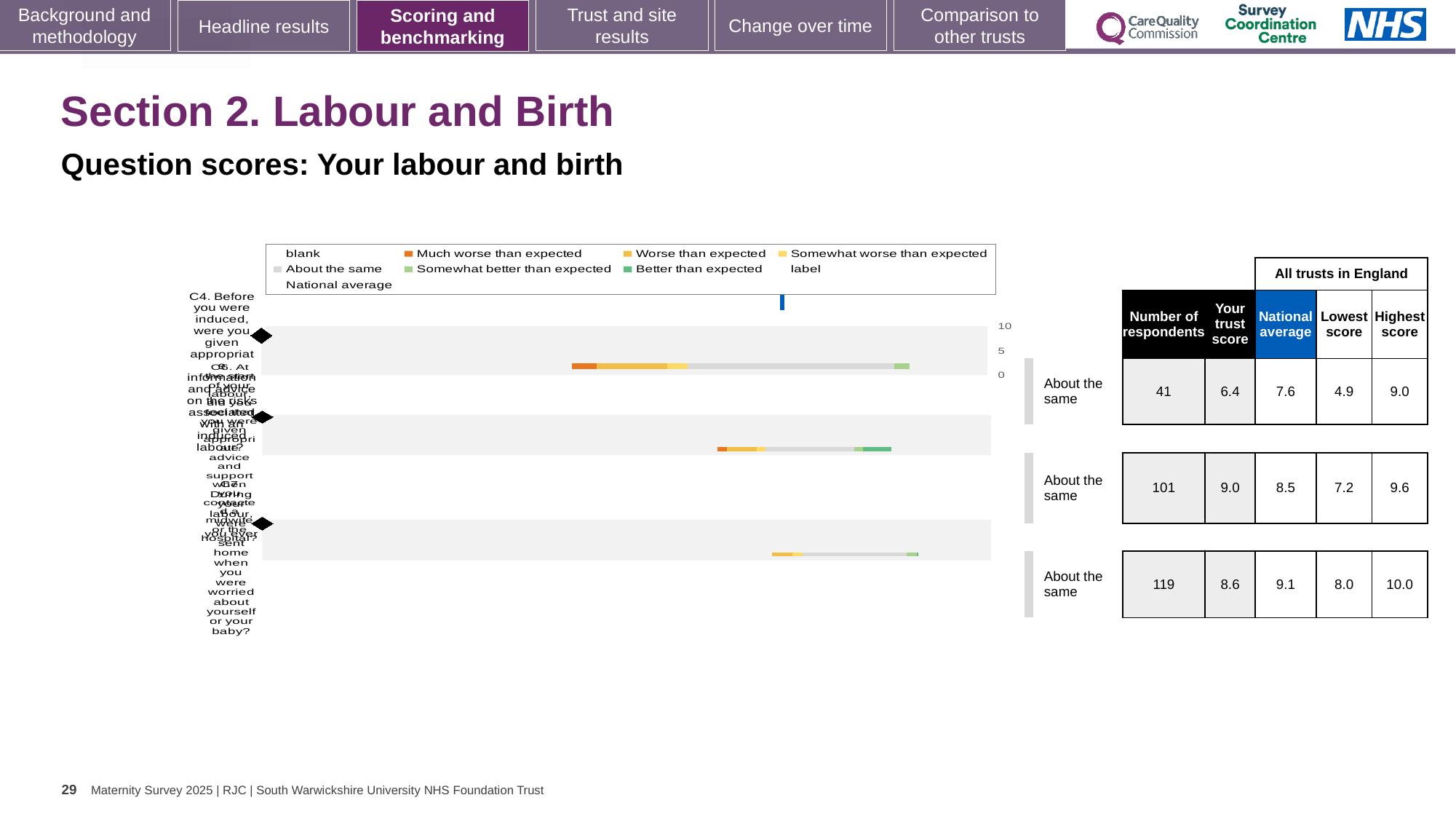
What benchmark label is shown beside each of the three bars in the chart? About the same What colour is the 'Much worse than expected' legend entry in the chart? orange In the table beside the chart, what is the number of respondents for the first row? 41 In the table beside the chart, what is the 'Your trust score' value for the first row? 6.4 What is the highest tick value shown on the chart's axis? 10 What kind of chart is shown on the slide? bar chart In the table beside the chart, which row has the largest number of respondents? the third row (119) How many horizontal bars are plotted in the chart? 3 In the table beside the chart, what is the difference between the trust score and the national average in the second row? 0.5 In the table beside the chart, is the trust score or the national average larger in the second row? the trust score (9.0) In the table beside the chart, what is the national average for the third row? 9.1 In the table beside the chart, what is the highest score for the third row? 10.0